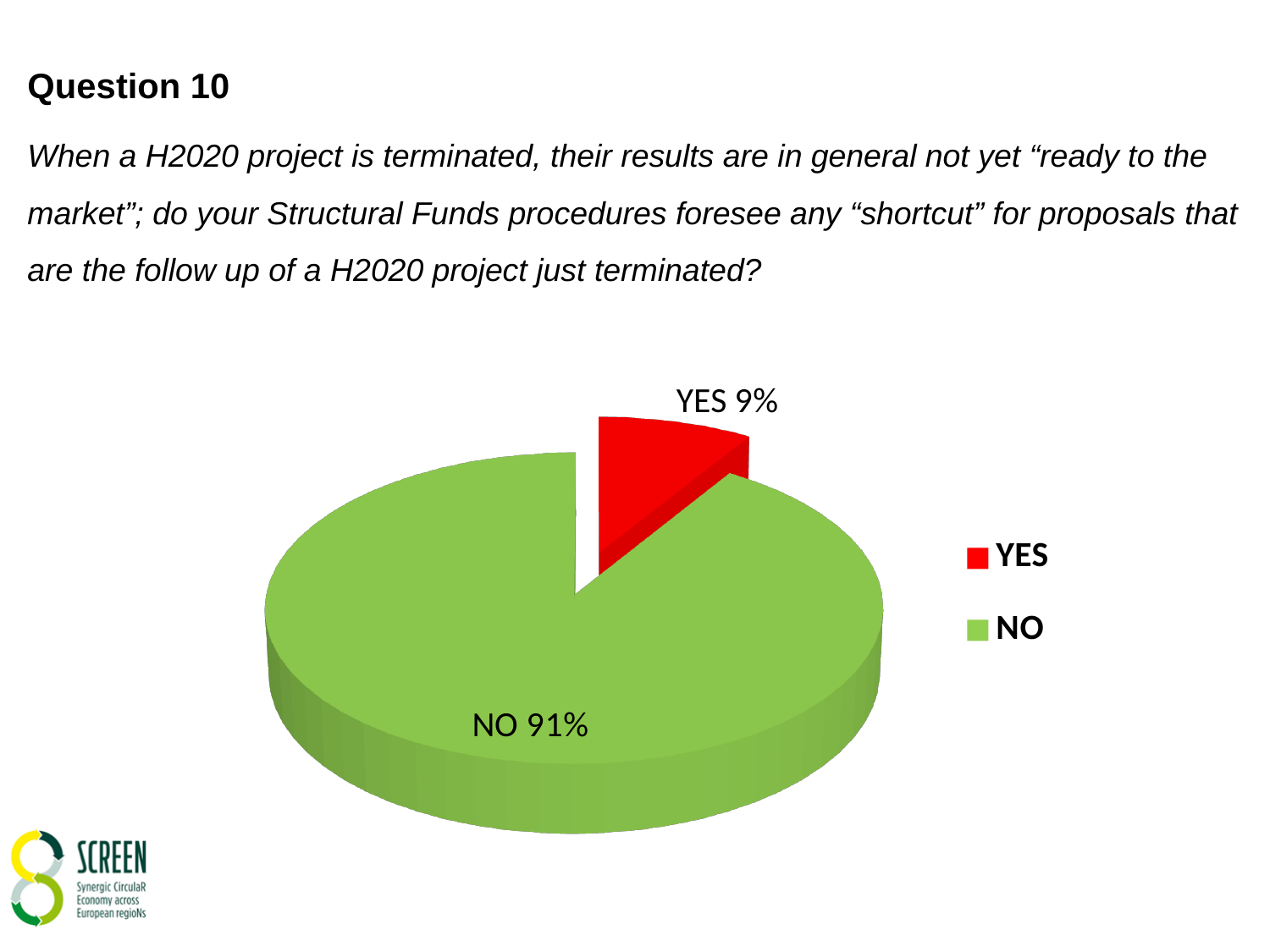
What colour is the NO slice in the pie chart? green What percentage of the pie is labelled YES? 9% What share of the pie does the NO slice represent? 91% What colour is the YES slice in the pie chart? red Which slice of the pie is the smallest? YES How many entries does the legend list? 2 What is the difference in percentage points between the NO slice and the YES slice? 82 Which is larger, the YES slice or the NO slice? NO What percentage of the pie is labelled NO? 91% Which slice of the pie is the largest? NO What kind of chart is shown on the slide? pie chart How many slices does the pie chart have? 2